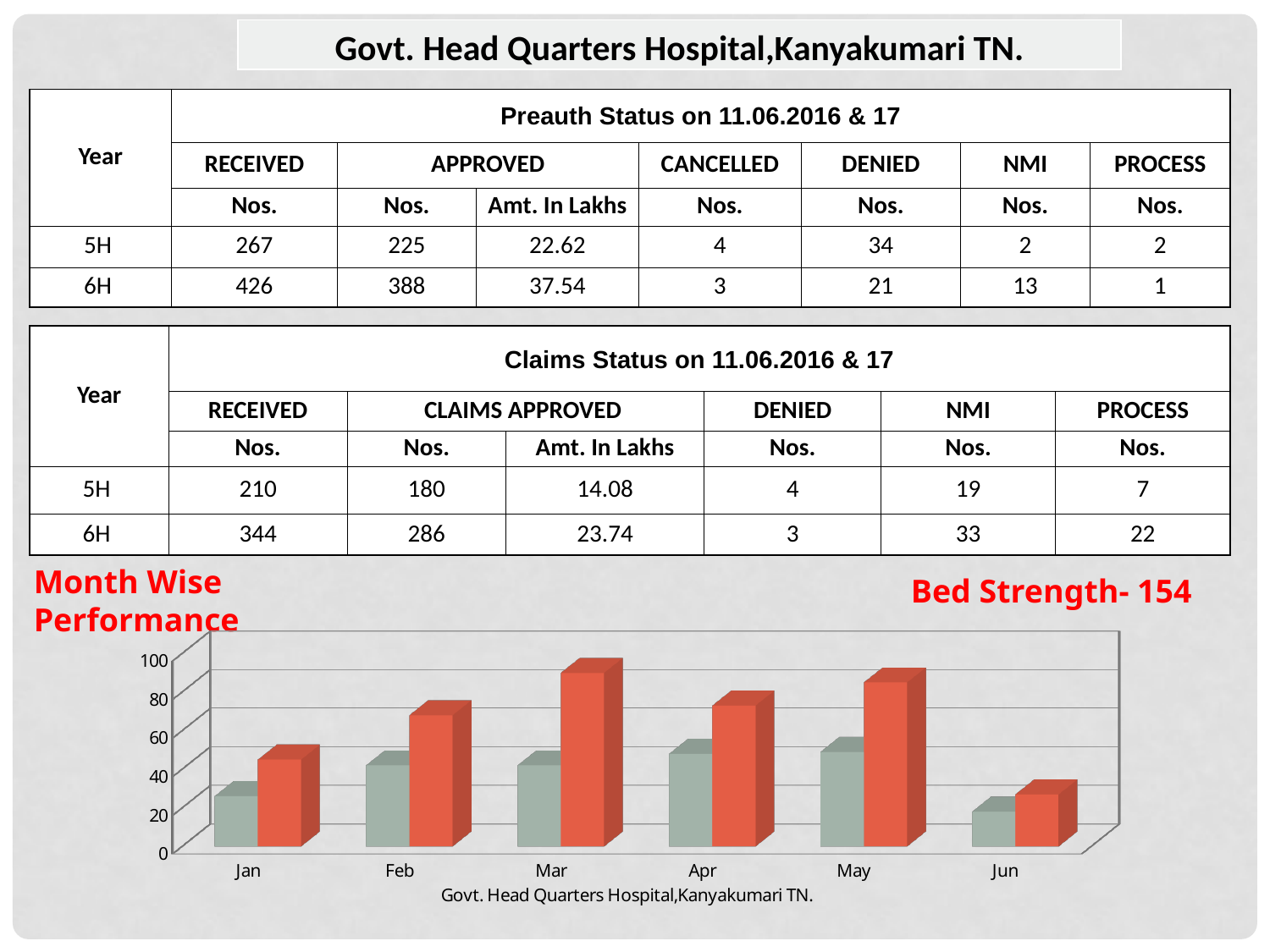
Is the red bar for Feb greater or less than 60? greater What kind of chart is shown on the slide? bar chart How many months are shown on the x axis of the chart? 6 In which month is the red bar the shortest? Jun In which month is the red bar the tallest? Mar Is the red bar for Jun greater or less than 40? less Is the grey bar for Jan greater or less than 40? less In Mar, which bar is taller, the red bar or the grey bar? the red bar What text appears below the x axis of the chart? Govt. Head Quarters Hospital,Kanyakumari TN. In which month is the grey bar the shortest? Jun Which month has the taller red bar, Jan or Feb? Feb